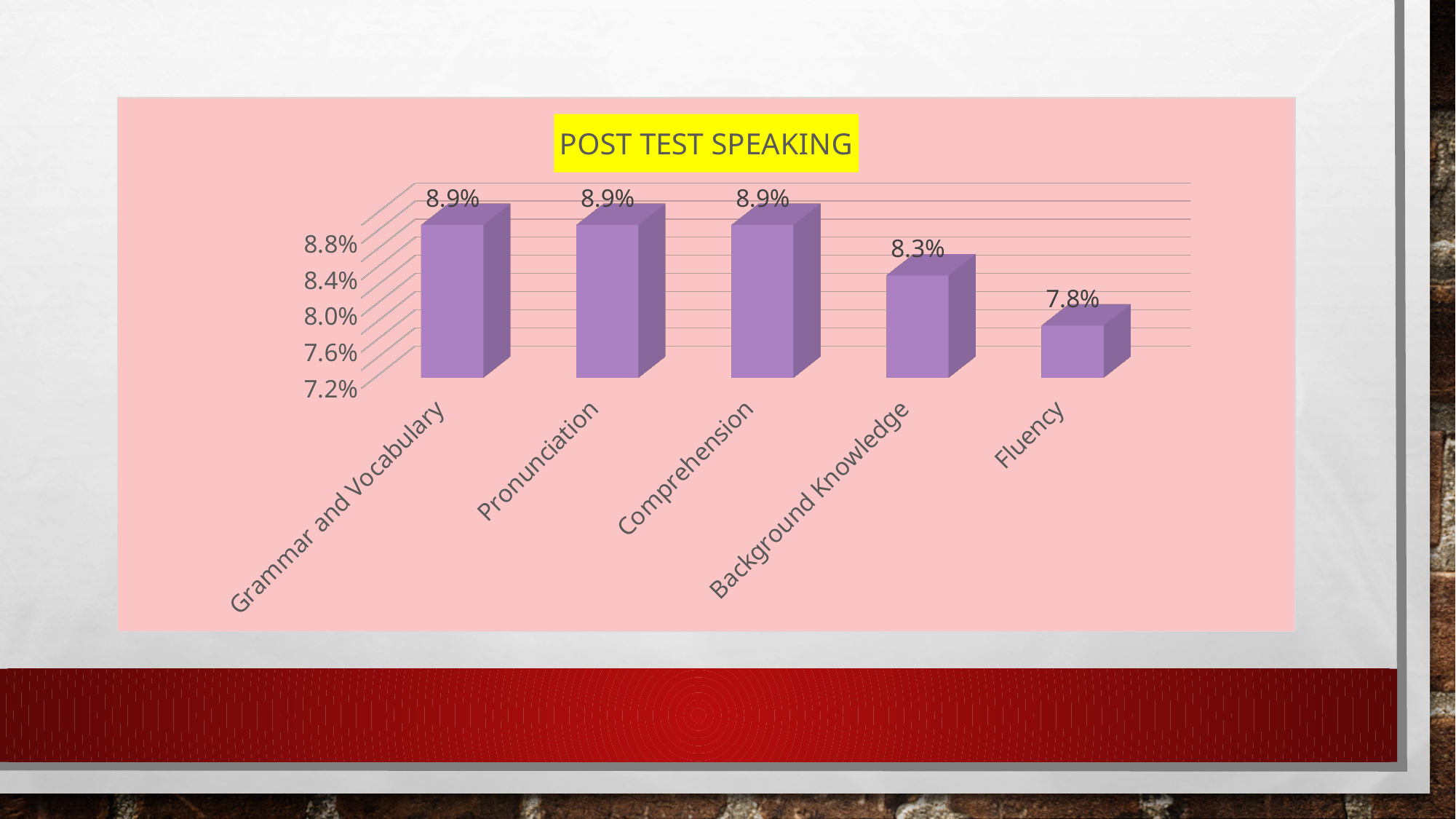
Which category has the lowest value? Fluency What kind of chart is shown on the slide? bar chart What is the difference between the values for Background Knowledge and Fluency? 0.5% What is the value for Background Knowledge? 8.3% Is the value for Fluency greater or less than 8.0%? less What is the value for Fluency? 7.8% Which is larger, the value for Background Knowledge or the value for Fluency? Background Knowledge What is the value for Grammar and Vocabulary? 8.9% What is the value for Pronunciation? 8.9% How many categories are shown in the chart? 5 What is the title of the chart? POST TEST SPEAKING What is the difference between the values for Comprehension and Background Knowledge? 0.6%